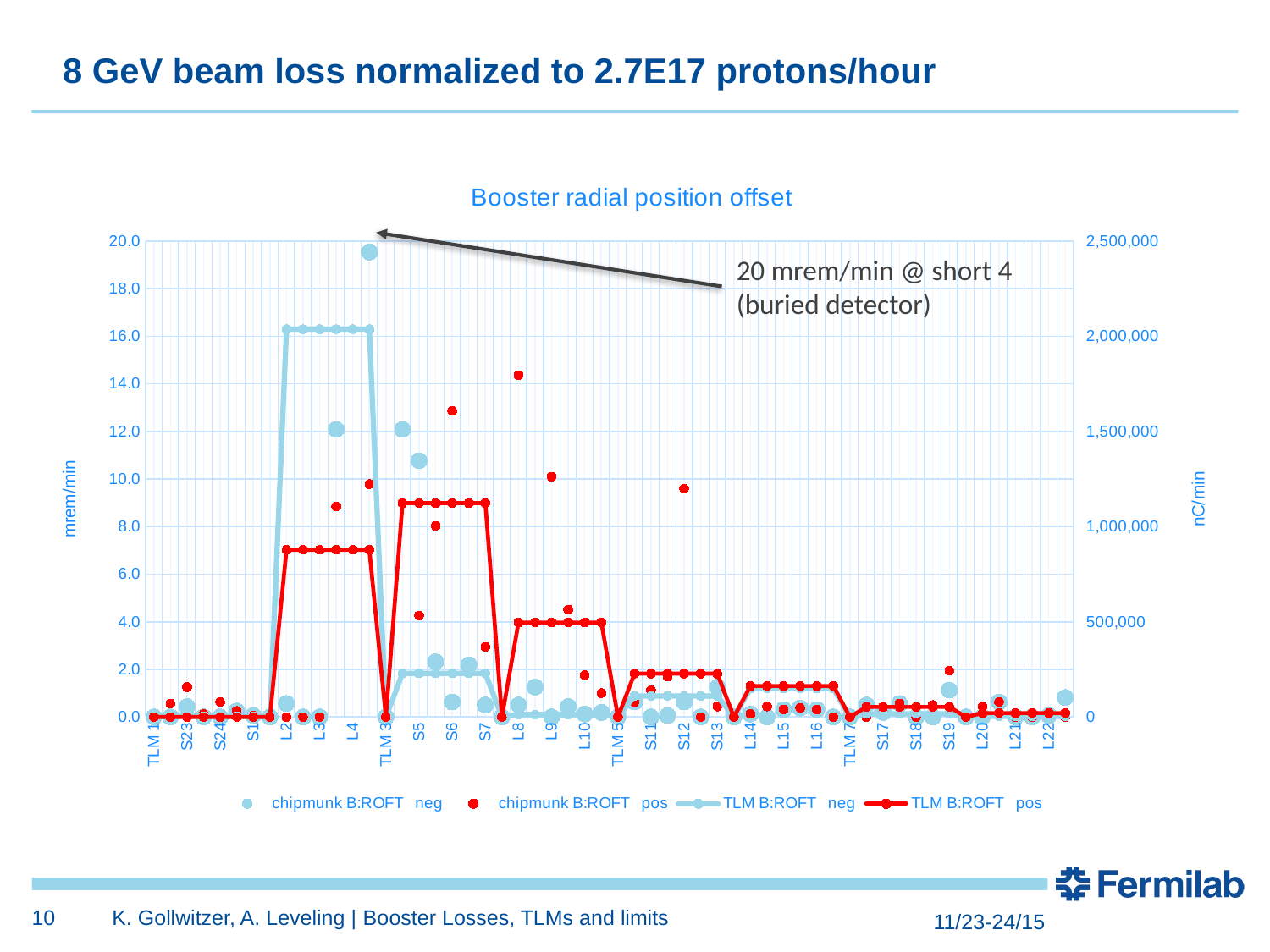
Is the TLM B:ROFT neg line at L3 greater or less than 1,500,000 on the right-hand nC/min axis? greater Which is higher: the chipmunk B:ROFT pos point at L8 or the chipmunk B:ROFT pos point at S12? L8 Is the highest chipmunk B:ROFT neg point (near L4) greater or less than 18.0 on the left axis? greater What is the label of the left-hand vertical axis? mrem/min Is the chipmunk B:ROFT pos point at S12 greater or less than 8.0 on the left axis? greater At L3, which line is higher: TLM B:ROFT neg or TLM B:ROFT pos? TLM B:ROFT neg What is the title of the chart on the slide? Booster radial position offset How many series does the chart legend list? 4 Which series contains the highest plotted point on the chart? chipmunk B:ROFT neg What kind of chart is shown on the slide? line chart